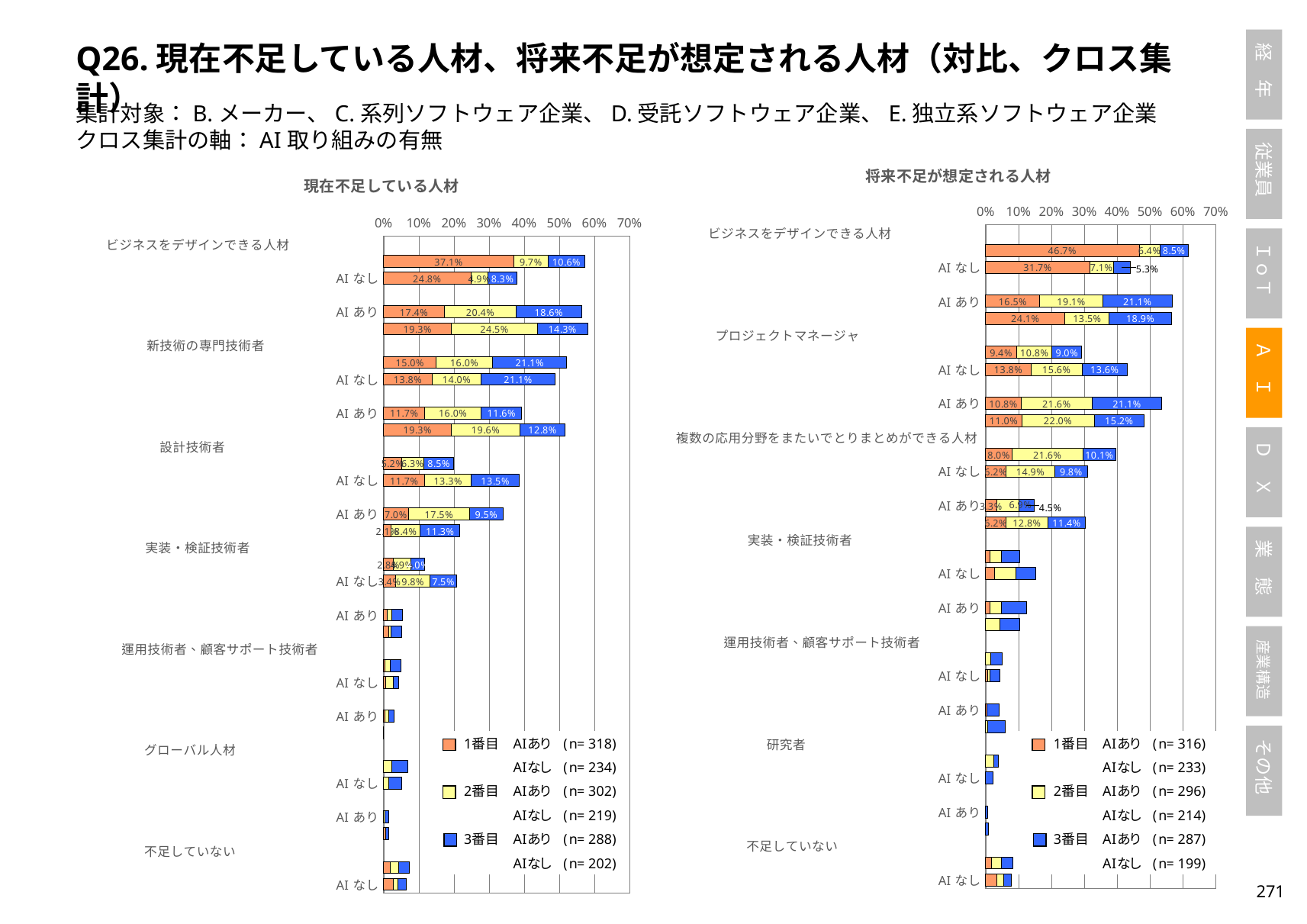
In the left chart 現在不足している人材, what is the largest 1番目 (orange) value printed on any bar? 37.1% According to the legend of the right chart 将来不足が想定される人材, what is the n for 1番目 AIあり? n= 316 In the left chart 現在不足している人材, what is the total of the topmost bar (37.1% + 9.7% + 10.6%)? 57.4% In the right chart 将来不足が想定される人材, what is the largest 1番目 (orange) value printed on any bar? 46.7% In the left chart 現在不足している人材, what is the 3番目 (blue) value on the topmost bar? 10.6% Which is larger: the largest 1番目 value in the left chart (37.1%) or the largest 1番目 value in the right chart (46.7%)? The right chart (46.7%) In the right chart 将来不足が想定される人材, what is the 2番目 (yellow) value on the topmost bar? 6.4% What is the difference between the largest 1番目 value in the right chart (46.7%) and the largest 1番目 value in the left chart (37.1%)? 9.6% What is the maximum value shown on the horizontal axis of the left chart 現在不足している人材? 70% In the right chart 将来不足が想定される人材, what is the total of the topmost bar (46.7% + 6.4% + 8.5%)? 61.6% How many series (1番目, 2番目, 3番目) does the legend of the right chart 将来不足が想定される人材 list? 3 What type of chart is the left chart titled 現在不足している人材? Stacked bar chart